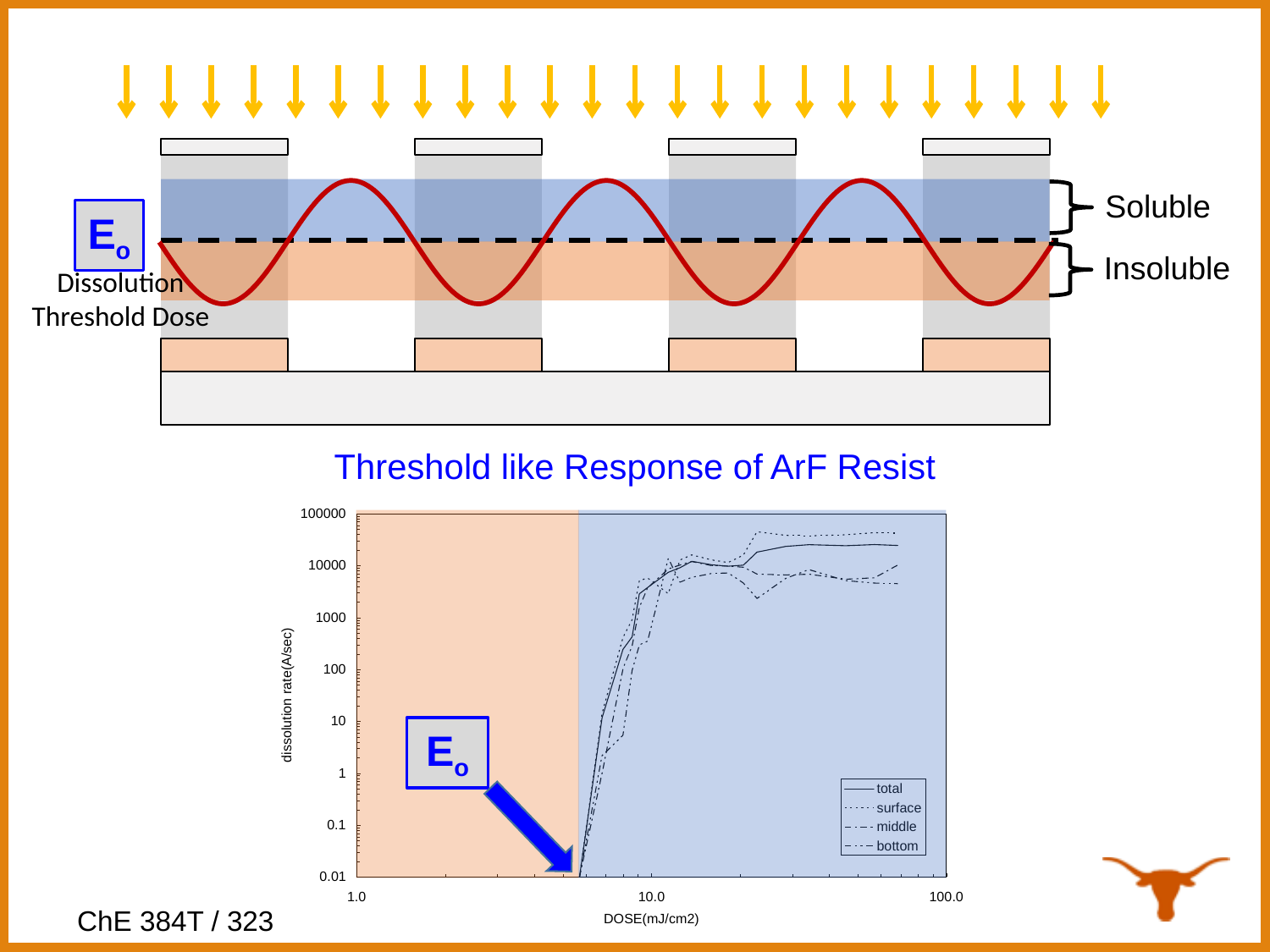
In the "Threshold like Response of ArF Resist" chart, at the highest plotted dose, which series has the larger dissolution rate: "surface" or "bottom"? surface In the "Threshold like Response of ArF Resist" chart, which series has the highest dissolution rate at the highest plotted dose? surface In the "Threshold like Response of ArF Resist" chart, is the dissolution rate of the "surface" series at the highest plotted dose greater or less than 10000 A/sec? greater What is the x-axis title of the "Threshold like Response of ArF Resist" chart? DOSE(mJ/cm2) What kind of chart is shown under the title "Threshold like Response of ArF Resist"? line chart How many series does the legend of the "Threshold like Response of ArF Resist" chart list? 4 In the "Threshold like Response of ArF Resist" chart, is the dissolution rate of the "total" series at the highest plotted dose greater or less than 10000 A/sec? greater In the "Threshold like Response of ArF Resist" chart, does the dissolution rate rise or fall as the dose increases from 1.0 to 100.0 mJ/cm2? rise What is the lowest value shown on the y-axis of the "Threshold like Response of ArF Resist" chart? 0.01 What are the series names listed in the legend of the "Threshold like Response of ArF Resist" chart? total, surface, middle, bottom In the "Threshold like Response of ArF Resist" chart, is the dissolution rate of the "total" series at a dose of 10.0 mJ/cm2 greater or less than 1000 A/sec? greater